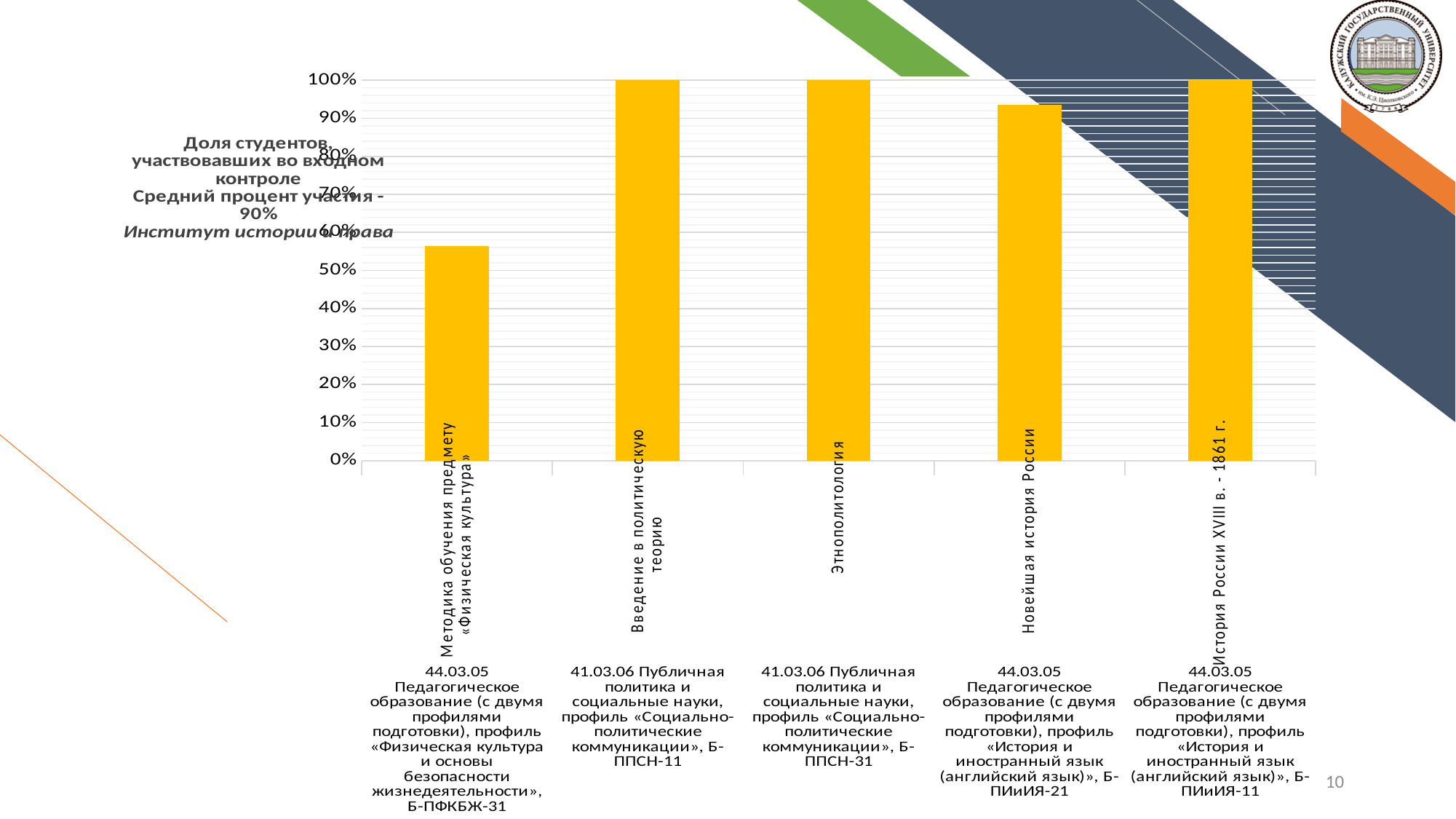
According to the chart title, what is the average participation percentage (Средний процент участия)? 90% Is the value for «Методика обучения предмету «Физическая культура»» greater or less than 50%? greater Which is larger: the value for «Этнополитология» or for «Новейшая история России»? Этнополитология What kind of chart is shown on the slide? bar chart Is the value for «Методика обучения предмету «Физическая культура»» greater or less than 60%? less What is the value for «Введение в политическую теорию»? 100% How many subjects (bars) are plotted in the chart? 5 What is the value for «История России XVIII в. - 1861 г.»? 100% How many bars reach 100%? 3 Is the value for «Новейшая история России» greater or less than 90%? greater What is the value for «Этнополитология»? 100% Which subject has the lowest share of students who took part in the entrance control? Методика обучения предмету «Физическая культура»